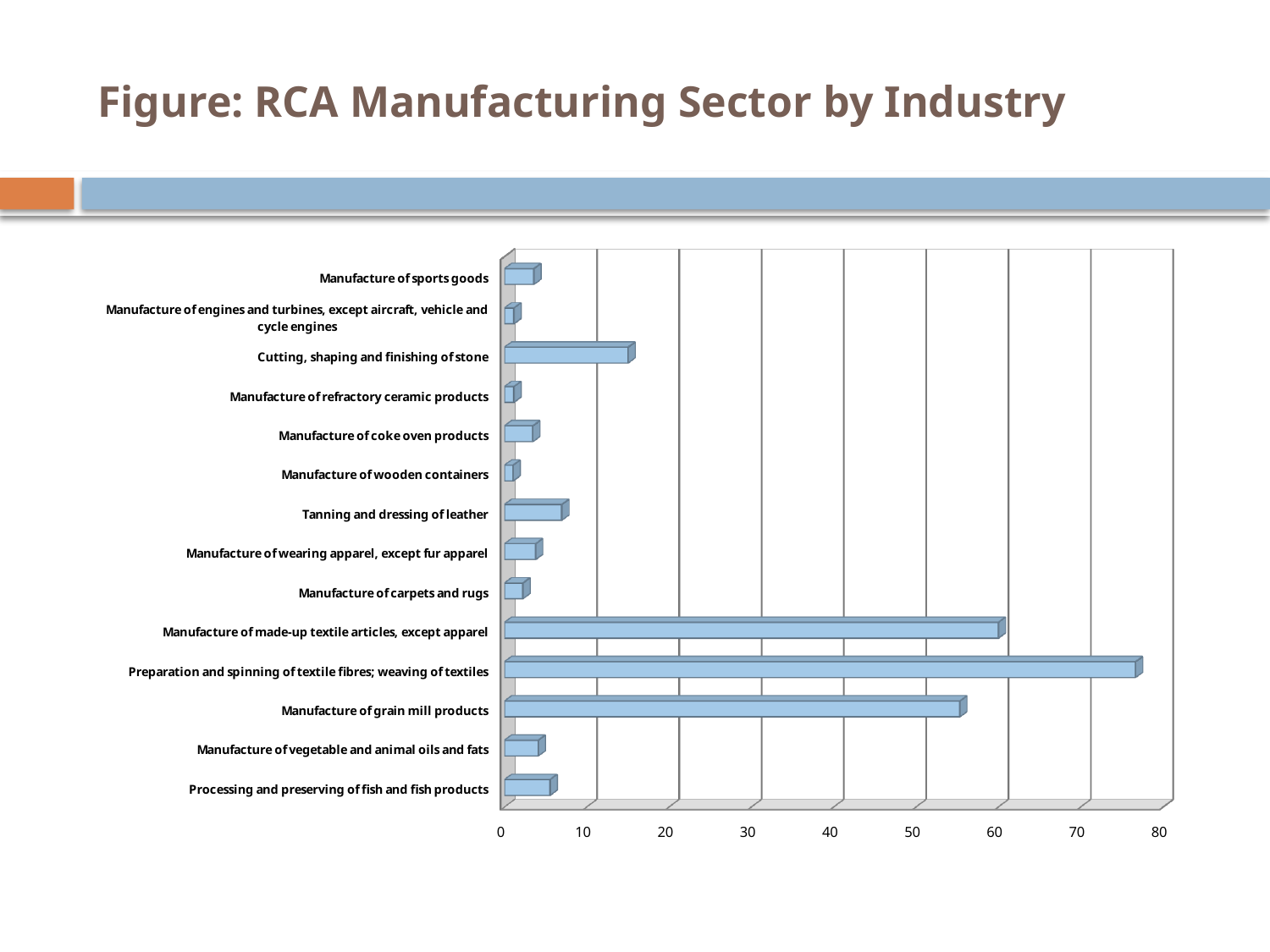
Is the value for Cutting, shaping and finishing of stone greater or less than 10? greater How many industry categories are plotted in the chart? 14 Is the value for Tanning and dressing of leather greater or less than 10? less Is the value for Manufacture of grain mill products greater or less than 50? greater What kind of chart is shown on the slide? bar chart Which is larger: the value for Cutting, shaping and finishing of stone or the value for Manufacture of sports goods? Cutting, shaping and finishing of stone What is the highest value shown on the horizontal axis of the chart? 80 What is the title of the figure on the slide? Figure: RCA Manufacturing Sector by Industry Which industry has the highest value in the chart? Preparation and spinning of textile fibres; weaving of textiles Which is larger: the value for Manufacture of made-up textile articles, except apparel or the value for Manufacture of grain mill products? Manufacture of made-up textile articles, except apparel